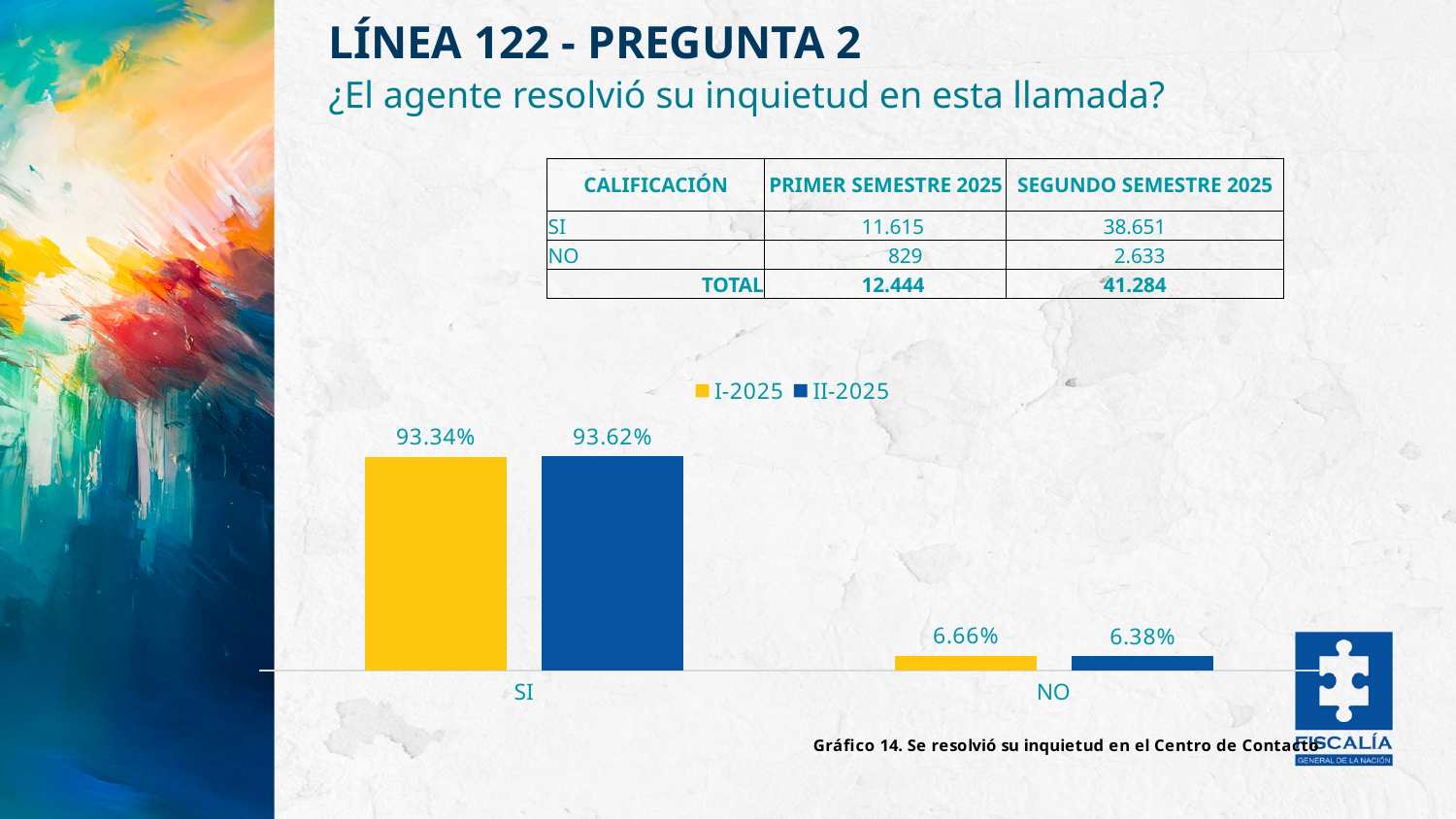
How many series does the chart legend list? 2 What is the difference between the I-2025 and II-2025 values for NO? 0.28% What is the value for NO in the II-2025 series? 6.38% What is the value for SI in the II-2025 series? 93.62% Which is larger for SI: the I-2025 value or the II-2025 value? II-2025 What is the value for SI in the I-2025 series? 93.34% Which category has the highest value in the II-2025 series? SI Which colour represents the I-2025 series in the chart? Yellow What kind of chart is shown on the slide? Bar chart What is the value for NO in the I-2025 series? 6.66% How many categories are shown on the x axis of the chart? 2 Which category has the lowest value in the I-2025 series? NO